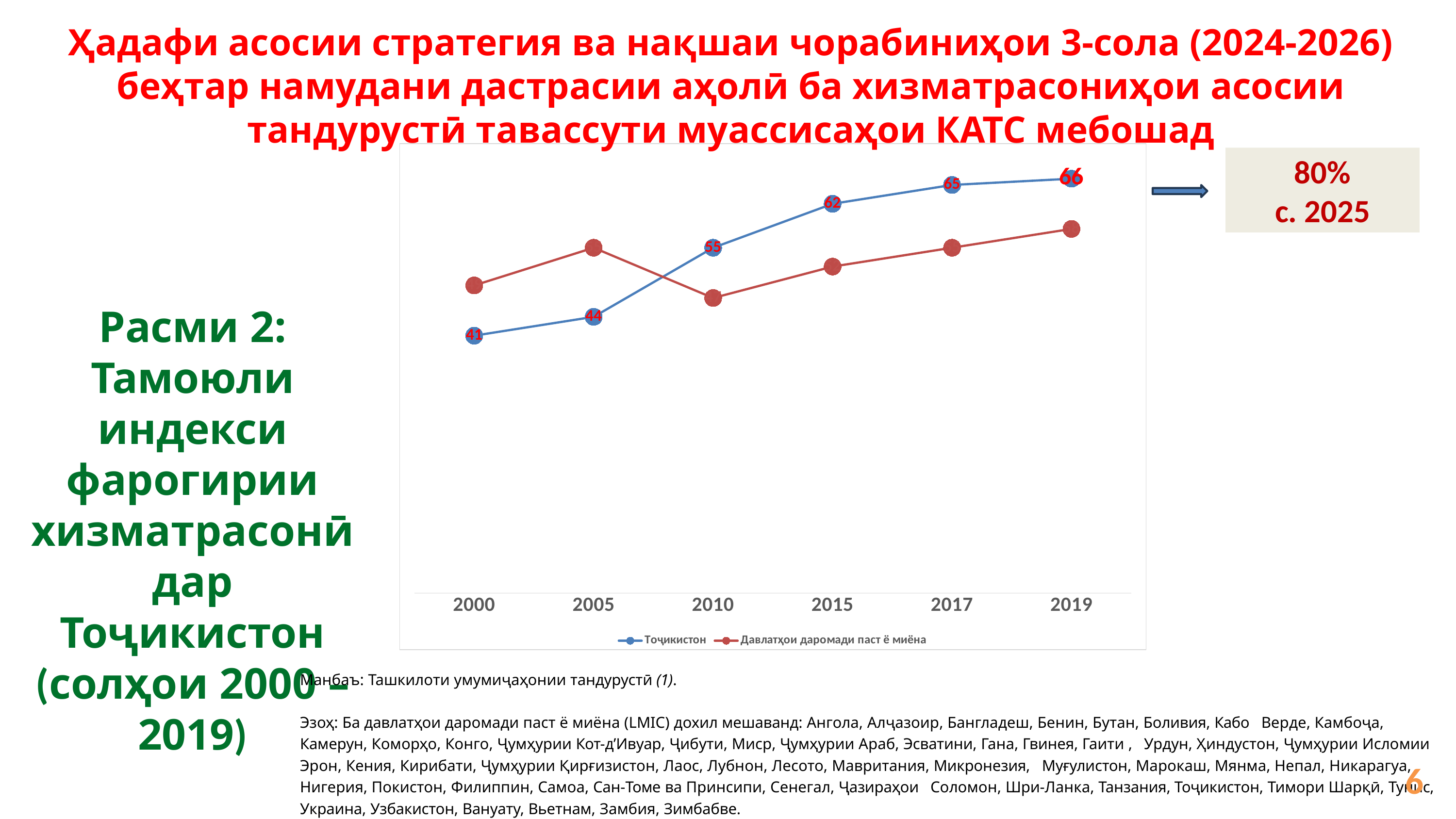
How many series does the chart legend list? 2 What type of chart is shown on the slide? line chart In which year is the value for Тоҷикистон highest? 2019 In 2000, which series has the higher value: Тоҷикистон or Давлатҳои даромади паст ё миёна? Давлатҳои даромади паст ё миёна What is the value for Тоҷикистон in 2010? 55 Does the Тоҷикистон series rise or fall from 2000 to 2019? rise What is the value for Тоҷикистон in 2019? 66 What is the difference between the Тоҷикистон values in 2019 and 2000? 25 What is the value for Тоҷикистон in 2000? 41 How many years are shown on the x axis of the chart? 6 What is the difference between the Тоҷикистон values in 2015 and 2010? 7 In which year is the value for Тоҷикистон lowest? 2000